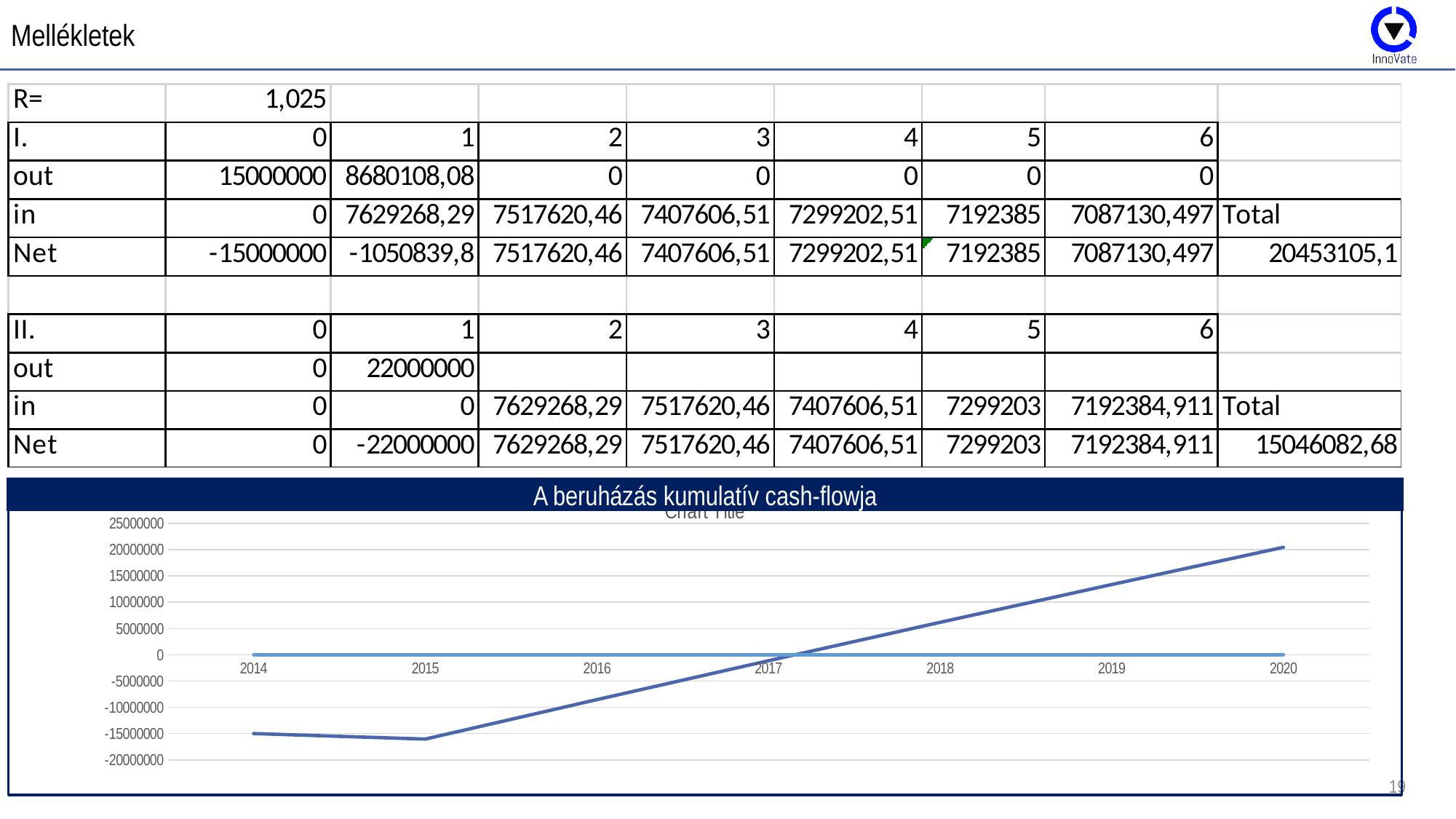
Is the cumulative cash-flow value for 2016 greater or less than -5000000? less Which year has the larger cumulative cash-flow value, 2016 or 2019? 2019 How many years are shown on the x axis of the chart? 7 What is the title shown in the banner above the chart? A beruházás kumulatív cash-flowja What kind of chart is shown at the bottom of the slide? line chart Is the cumulative cash-flow value for 2020 greater or less than 15000000? greater What is the highest value labelled on the chart's y axis? 25000000 Does the cumulative cash-flow line rise or fall between 2015 and 2020? rise In which year does the cumulative cash-flow line reach its highest point? 2020 Is the cumulative cash-flow value for 2014 greater or less than -10000000? less In which year does the cumulative cash-flow line reach its lowest point? 2015